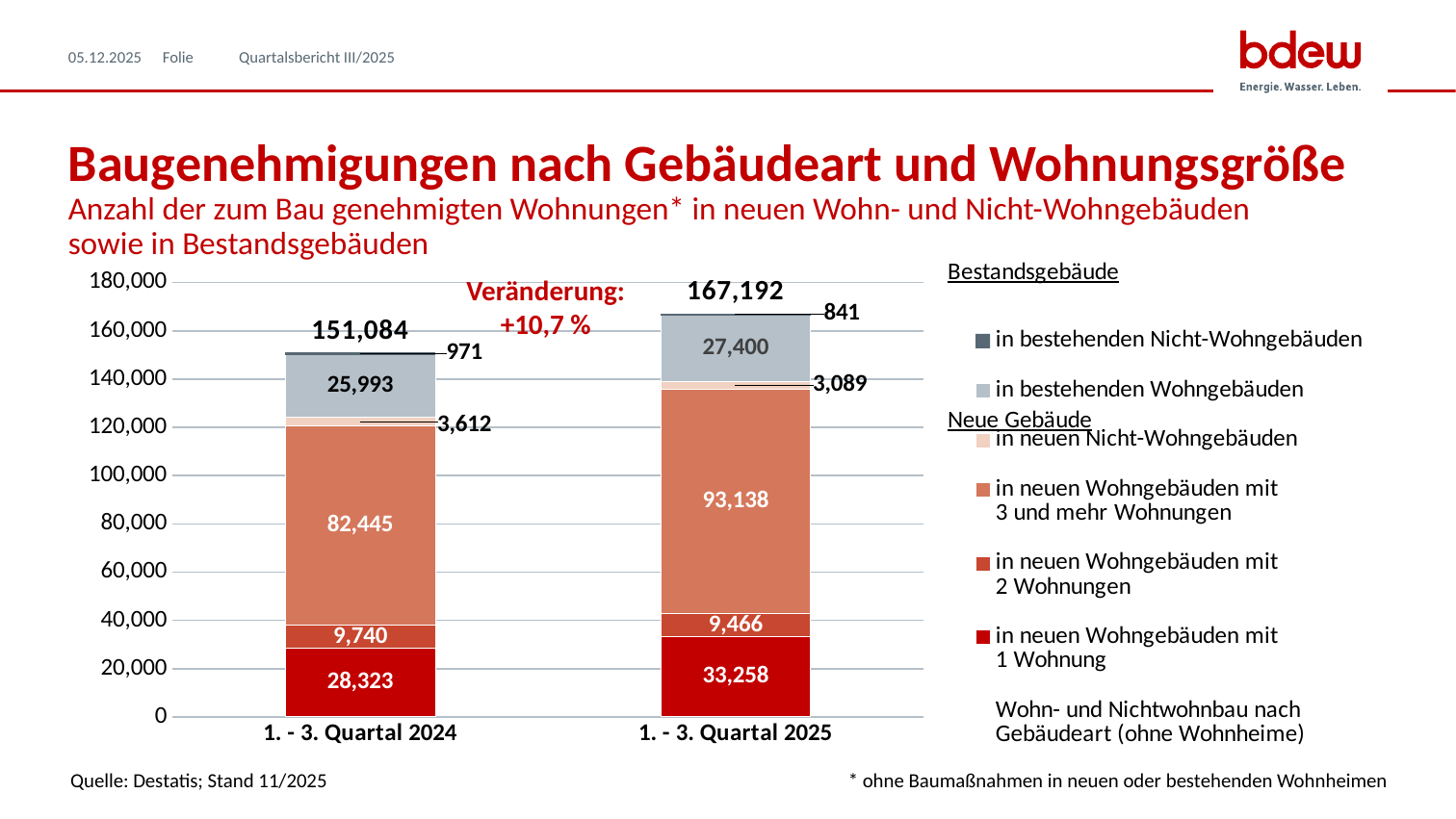
Which segment is the smallest in the 1. - 3. Quartal 2024 bar? in bestehenden Nicht-Wohngebäuden What percentage change between the two bars is annotated on the chart? +10,7 % Which segment is the largest in the 1. - 3. Quartal 2025 bar? in neuen Wohngebäuden mit 3 und mehr Wohnungen How many series does the legend list? 7 By how much did the value for 'in neuen Wohngebäuden mit 1 Wohnung' change from 1. - 3. Quartal 2024 to 1. - 3. Quartal 2025? 4,935 Is the value for 'in neuen Wohngebäuden mit 2 Wohnungen' larger in 1. - 3. Quartal 2024 or in 1. - 3. Quartal 2025? 1. - 3. Quartal 2024 What is the value for 'in neuen Wohngebäuden mit 3 und mehr Wohnungen' in 1. - 3. Quartal 2025? 93,138 What is the total number of approved dwellings shown for 1. - 3. Quartal 2025? 167,192 What is the value for 'in bestehenden Nicht-Wohngebäuden' in 1. - 3. Quartal 2024? 971 What is the total number of approved dwellings shown for 1. - 3. Quartal 2024? 151,084 What is the value for 'in neuen Wohngebäuden mit 1 Wohnung' in 1. - 3. Quartal 2024? 28,323 What is the value for 'in bestehenden Wohngebäuden' in 1. - 3. Quartal 2025? 27,400